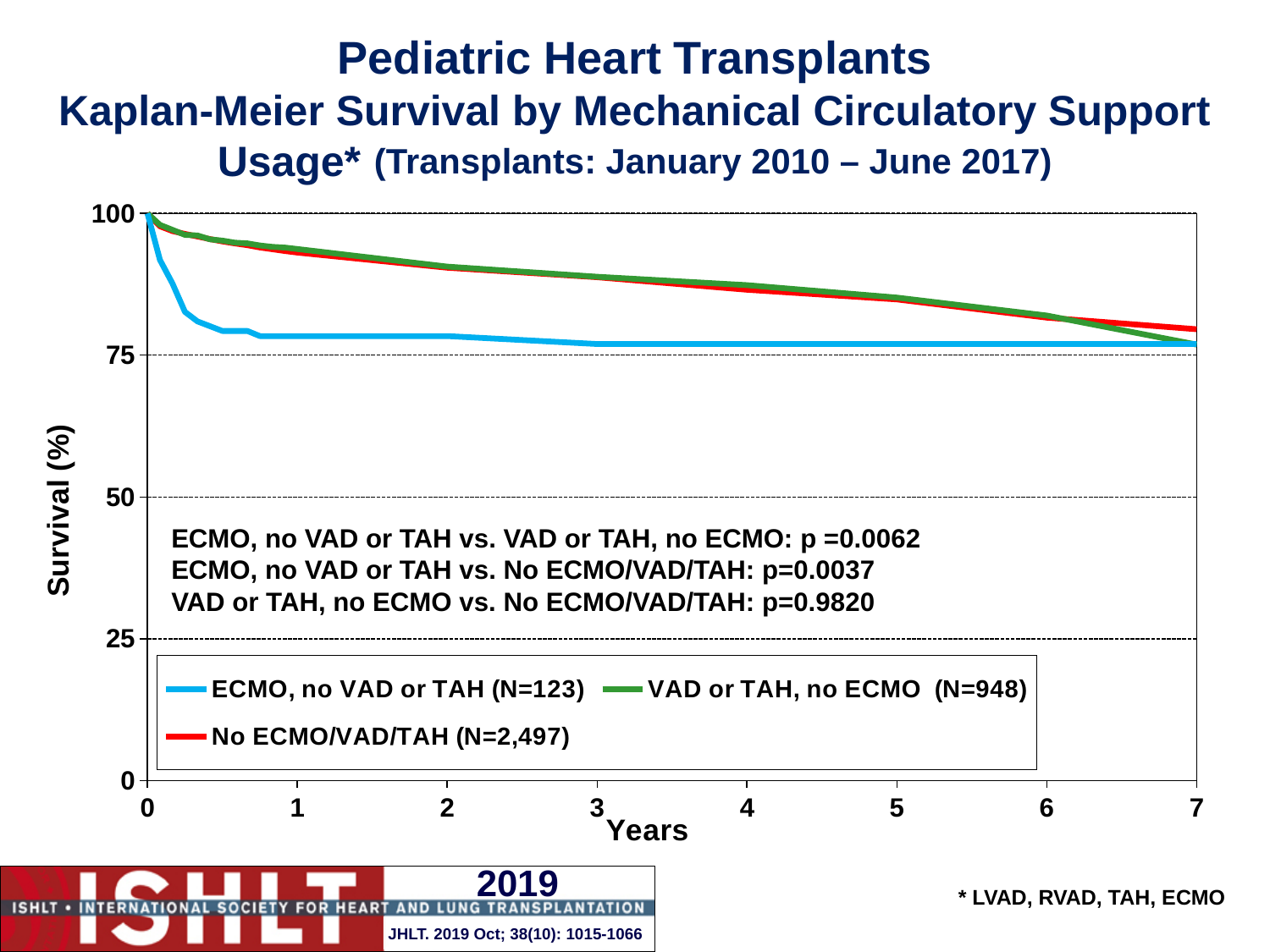
Which series has the lowest survival at 1 year? ECMO, no VAD or TAH Is the survival for ECMO, no VAD or TAH at 2 years greater or less than 50? greater How many series does the legend list? 3 Is the survival for VAD or TAH, no ECMO at 1 year greater or less than 75? greater Is the survival for ECMO, no VAD or TAH at 1 year greater or less than 100? less What is the N for the ECMO, no VAD or TAH group shown in the legend? N=123 Do the survival curves rise or fall as years increase? fall What p-value is shown for VAD or TAH, no ECMO vs. No ECMO/VAD/TAH? p=0.9820 At 3 years, which is higher: the survival for VAD or TAH, no ECMO or for ECMO, no VAD or TAH? VAD or TAH, no ECMO Which series has the lowest survival at 5 years? ECMO, no VAD or TAH What kind of chart is shown on the slide? line chart